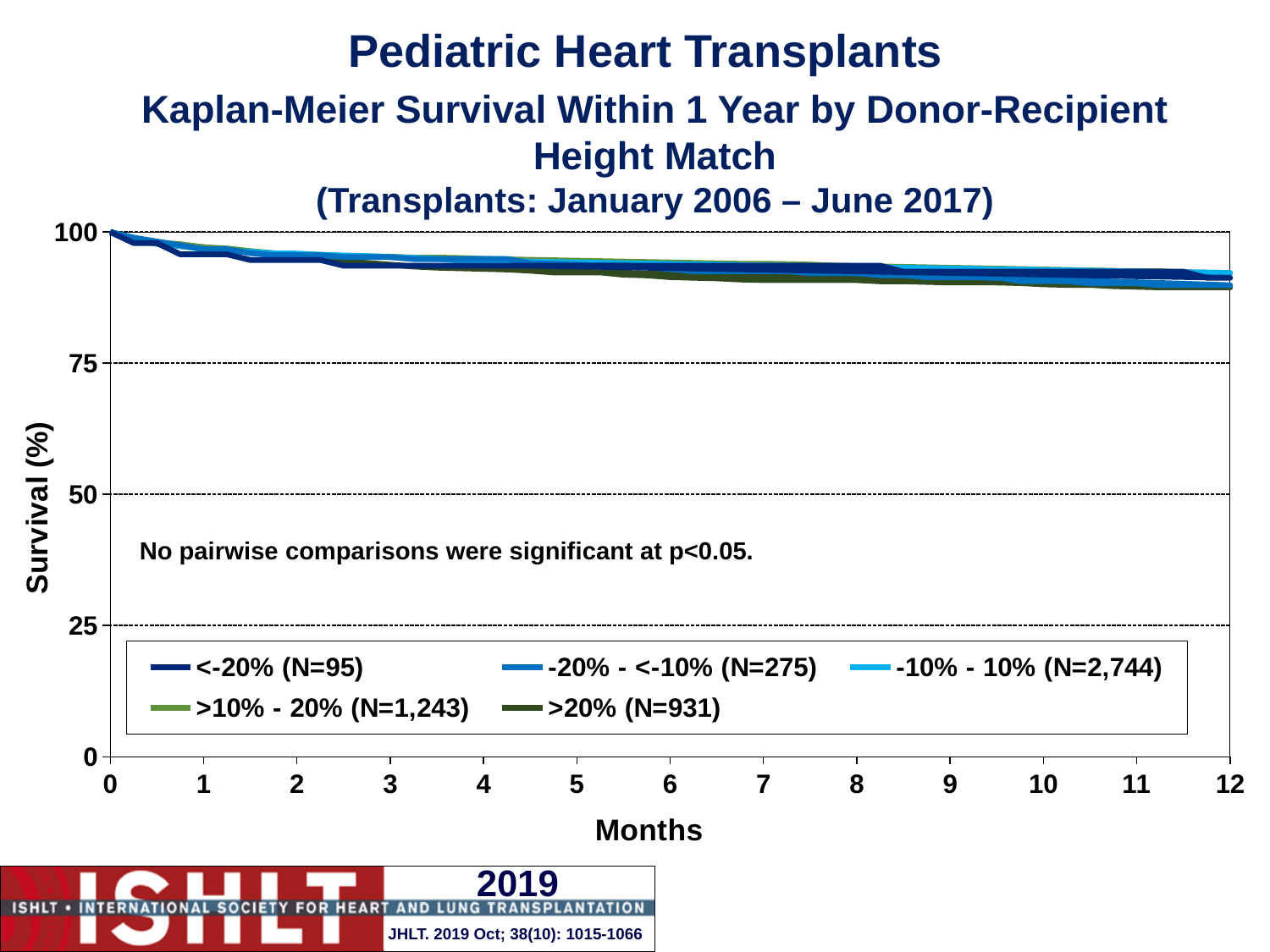
What kind of chart is shown on the slide? line chart Is the survival value for the <-20% group at 12 months greater or less than 75? greater Is the survival value for the >10% - 20% group at 3 months greater or less than 75? greater Is the survival value for the >20% group at 6 months greater or less than 50? greater What is the N shown in the legend for the -10% - 10% group? N=2,744 Do the survival curves rise or fall as months increase along the x axis? fall What is the label of the x axis? Months How many series does the legend list? 5